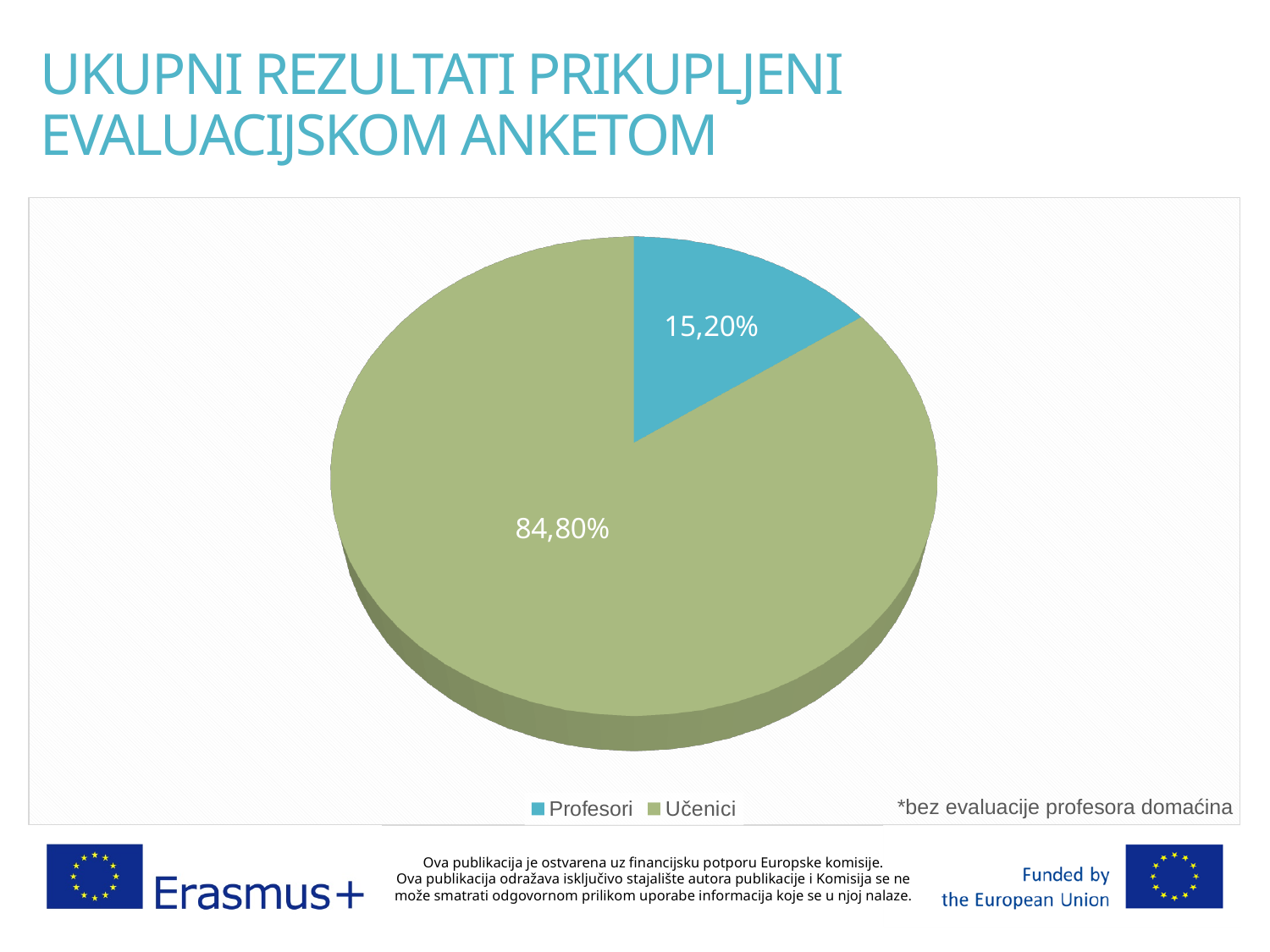
What is the difference in percentage points between the Učenici and Profesori slices? 69,60% What note appears at the bottom right of the chart area? *bez evaluacije profesora domaćina How many categories does the pie chart show? 2 Which category has the smallest slice of the pie? Profesori Which slice is larger, Profesori or Učenici? Učenici What kind of chart is shown on the slide? pie chart How many entries does the legend list? 2 Which category has the largest slice of the pie? Učenici What share of the pie does Profesori represent? 15,20% What colour is the Profesori slice? blue What share of the pie does Učenici represent? 84,80%